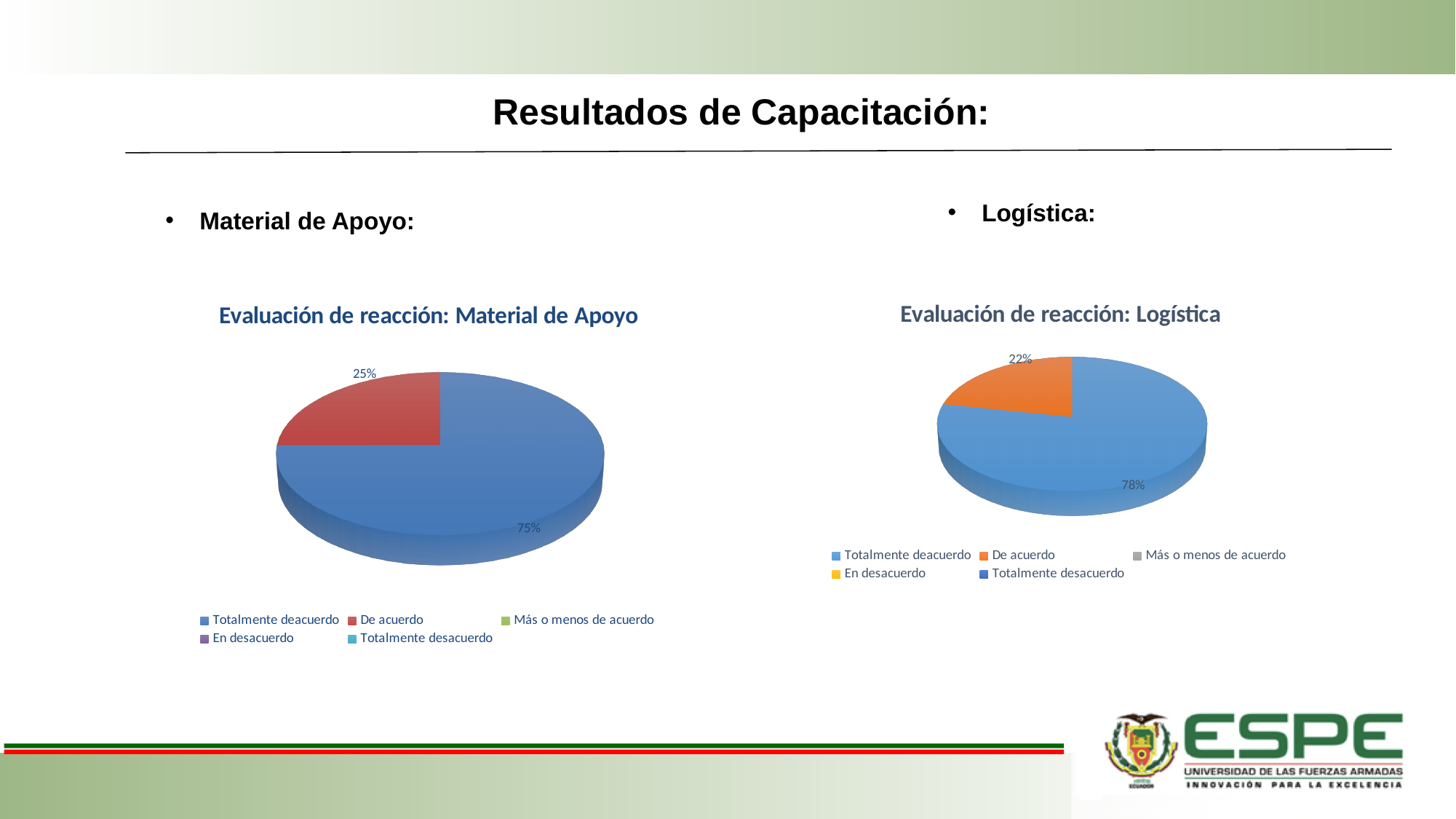
In the chart titled 'Evaluación de reacción: Logística', which category has the smallest visible slice? De acuerdo In the chart titled 'Evaluación de reacción: Material de Apoyo', what is the difference in percentage points between the 'Totalmente deacuerdo' and 'De acuerdo' slices? 50 In the chart titled 'Evaluación de reacción: Material de Apoyo', what share of the pie is 'Totalmente deacuerdo'? 75% In the chart titled 'Evaluación de reacción: Logística', what colour is the 'De acuerdo' slice? Orange Which is larger: the 'Totalmente deacuerdo' share in the 'Material de Apoyo' chart or the 'Totalmente deacuerdo' share in the 'Logística' chart? Logística In the chart titled 'Evaluación de reacción: Logística', what share of the pie is 'De acuerdo'? 22% In the chart titled 'Evaluación de reacción: Logística', what is the difference in percentage points between the 'Totalmente deacuerdo' and 'De acuerdo' slices? 56 In the chart titled 'Evaluación de reacción: Material de Apoyo', what share of the pie is 'De acuerdo'? 25% How many entries does the legend of the chart titled 'Evaluación de reacción: Material de Apoyo' list? 5 In the chart titled 'Evaluación de reacción: Material de Apoyo', which category has the largest slice? Totalmente deacuerdo What type of chart is 'Evaluación de reacción: Logística'? Pie chart